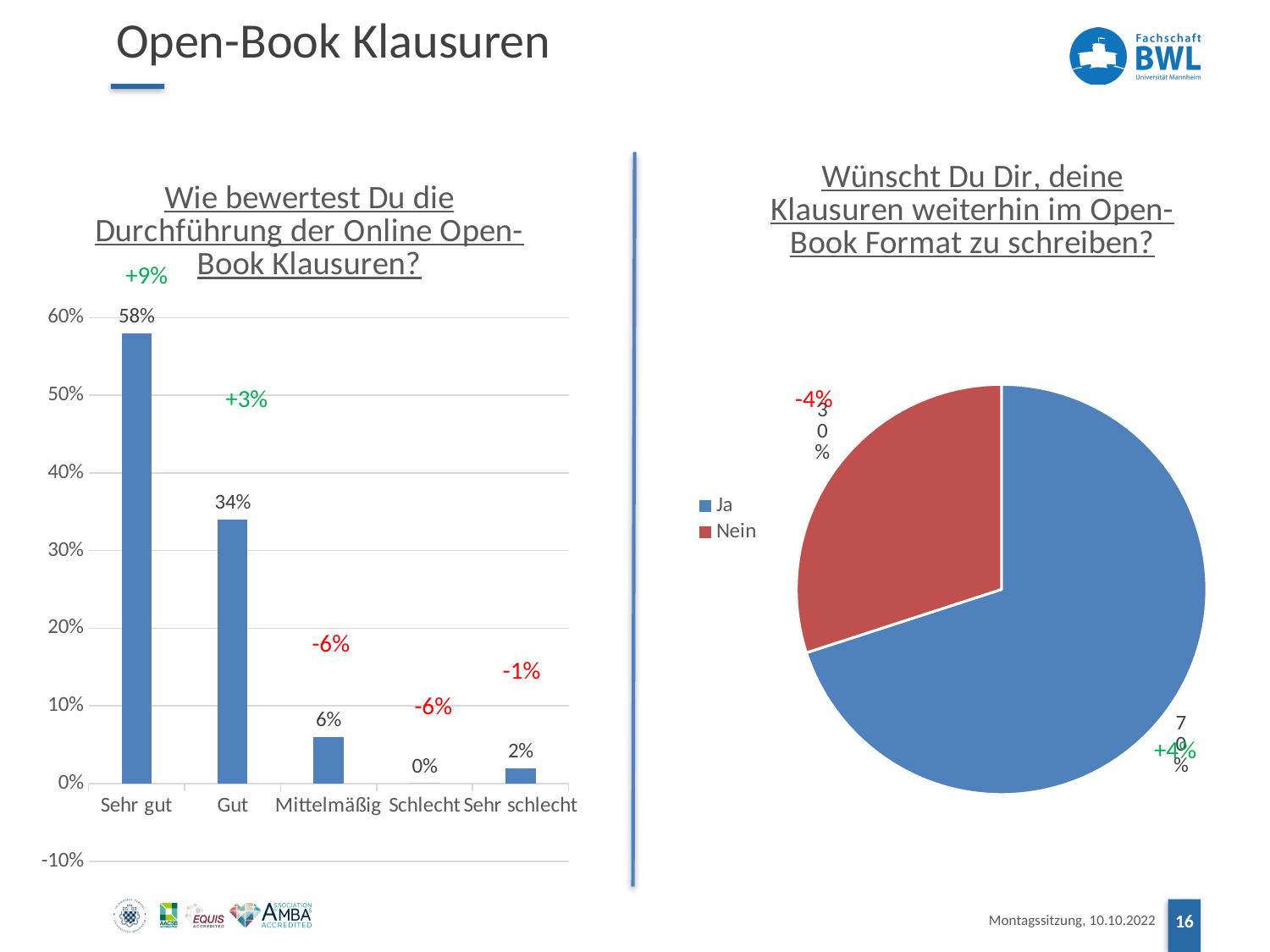
In the bar chart on the left, which is larger: the value for "Mittelmäßig" or the value for "Sehr schlecht"? Mittelmäßig In the bar chart on the left, what is the value for "Sehr gut"? 58% In the bar chart on the left, which category has the lowest value? Schlecht How many categories are shown on the x axis of the bar chart on the left? 5 In the bar chart on the left, what is the value for "Gut"? 34% In the pie chart on the right, which slice is larger: "Ja" or "Nein"? Ja How many entries does the legend of the pie chart on the right list? 2 In the bar chart on the left, which category has the highest value? Sehr gut In the bar chart on the left, what is the value for "Mittelmäßig"? 6% What kind of chart is the chart on the left of the slide? Bar chart In the bar chart on the left, what is the difference between the values for "Sehr gut" and "Gut"? 24% In the bar chart on the left, what is the value for "Sehr schlecht"? 2%